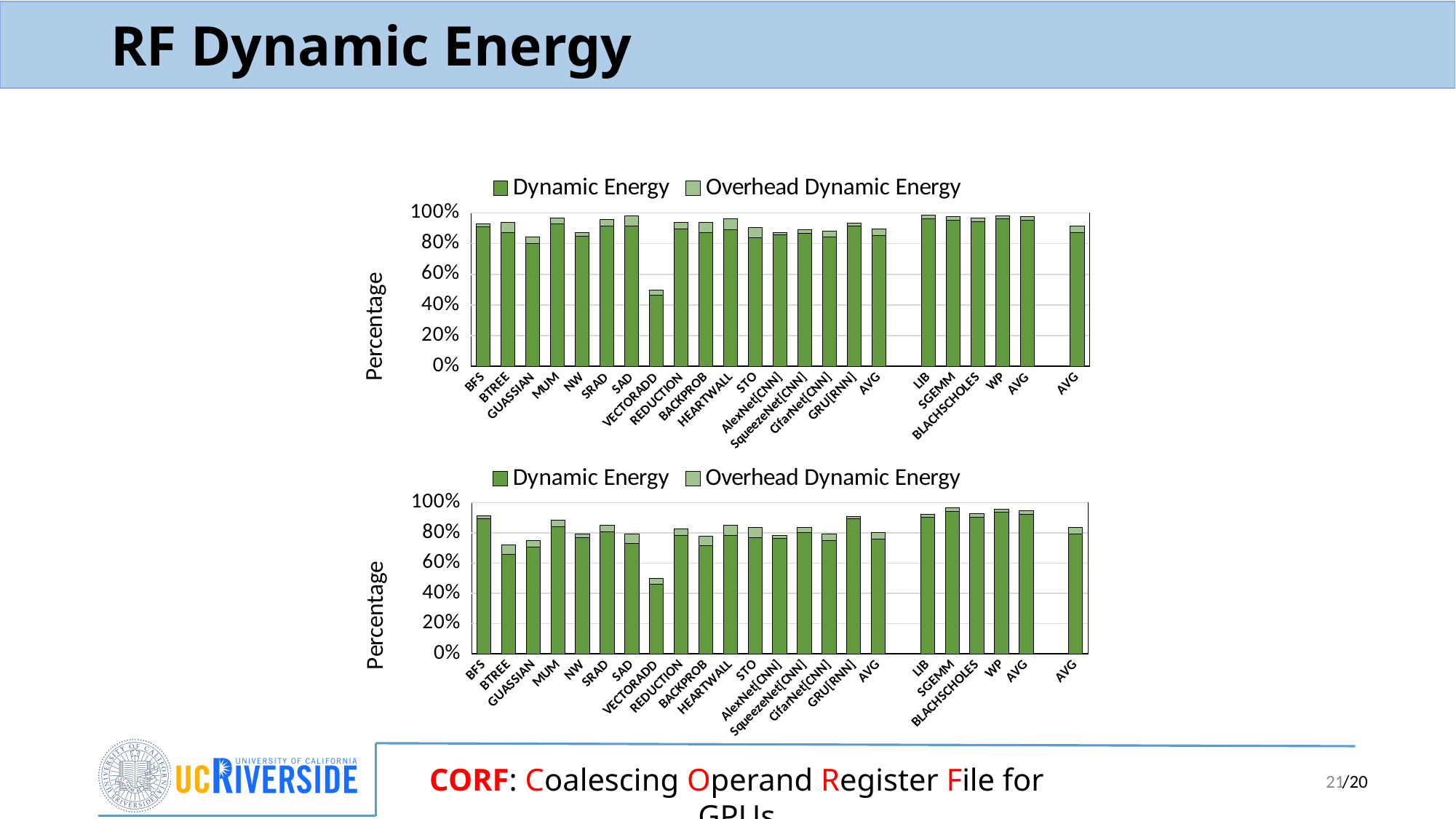
In the top chart, which has the larger total bar, BFS or VECTORADD? BFS What kind of chart is the top chart on the slide? stacked bar chart What is the y-axis label of the bottom chart? Percentage In the bottom chart, is the total value for SGEMM greater or less than 80%? greater In the top chart, which category has the lowest total bar? VECTORADD In the bottom chart, is the total value for BTREE greater or less than 80%? less In the bottom chart, which category has the lowest total bar? VECTORADD In the top chart, is the total value for VECTORADD greater or less than 60%? less What are the two legend entries of the bottom chart? Dynamic Energy and Overhead Dynamic Energy How many series does the legend of the top chart list? 2 In the bottom chart, which has the larger total bar, MUM or BTREE? MUM